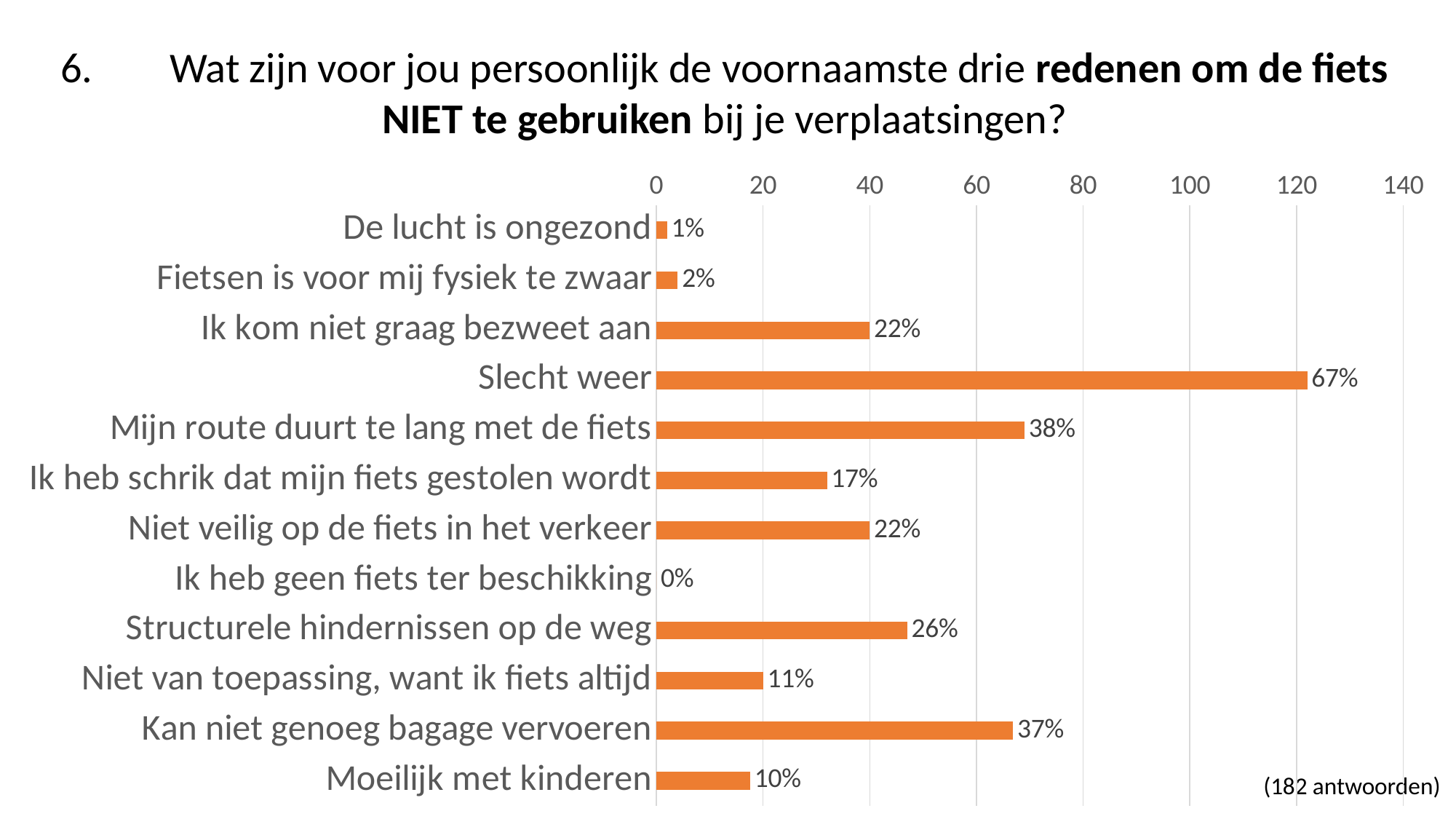
Which category has the lowest value? Ik heb geen fiets ter beschikking Which category has the highest value? Slecht weer How many categories are shown in the chart? 12 What is the value for "Slecht weer"? 67% Which is larger: the value for "Structurele hindernissen op de weg" or the value for "Niet van toepassing, want ik fiets altijd"? Structurele hindernissen op de weg What is the value for "Kan niet genoeg bagage vervoeren"? 37% Is the bar for "Slecht weer" greater or less than 100 on the axis? greater Is the bar for "Mijn route duurt te lang met de fiets" greater or less than 60 on the axis? greater What is the value for "Ik heb schrik dat mijn fiets gestolen wordt"? 17% What is the difference between the values for "Slecht weer" and "Mijn route duurt te lang met de fiets"? 29% What is the value for "Moeilijk met kinderen"? 10% What kind of chart is shown on the slide? Bar chart